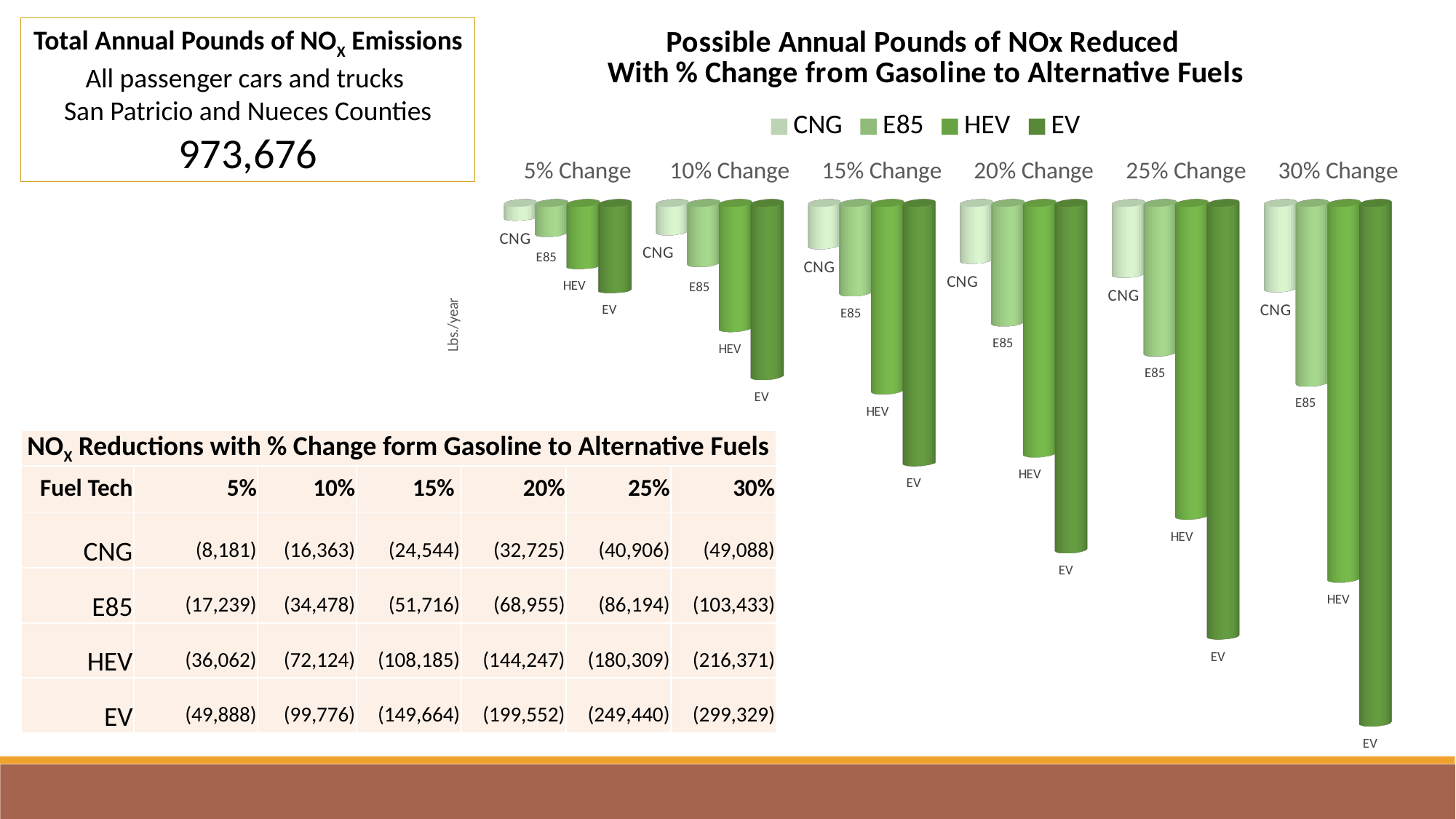
In the 'Possible Annual Pounds of NOx Reduced' chart, which fuel technology has the shortest bar in the 5% Change group? CNG How many series does the legend of the 'Possible Annual Pounds of NOx Reduced' chart list? 4 According to the NOx Reductions table, what is the CNG value at 5%? (8,181) In the 'Possible Annual Pounds of NOx Reduced' chart, is the HEV bar or the E85 bar longer in the 20% Change group? HEV What kind of chart is shown under the title 'Possible Annual Pounds of NOx Reduced With % Change from Gasoline to Alternative Fuels'? bar chart According to the NOx Reductions table, what is the HEV value at 15%? (108,185) In the 'Possible Annual Pounds of NOx Reduced' chart, which fuel technology has the longest bar in the 30% Change group? EV Using the NOx Reductions table, what is the difference between the HEV and E85 values at 10%? 37,646 In the 'Possible Annual Pounds of NOx Reduced' chart, do the bars get longer or shorter as the % Change increases from 5% to 30%? longer How many % Change categories are shown along the x axis of the 'Possible Annual Pounds of NOx Reduced' chart? 6 What is the y-axis label of the 'Possible Annual Pounds of NOx Reduced' chart? Lbs./year According to the NOx Reductions table, what is the EV value at 30%? (299,329)